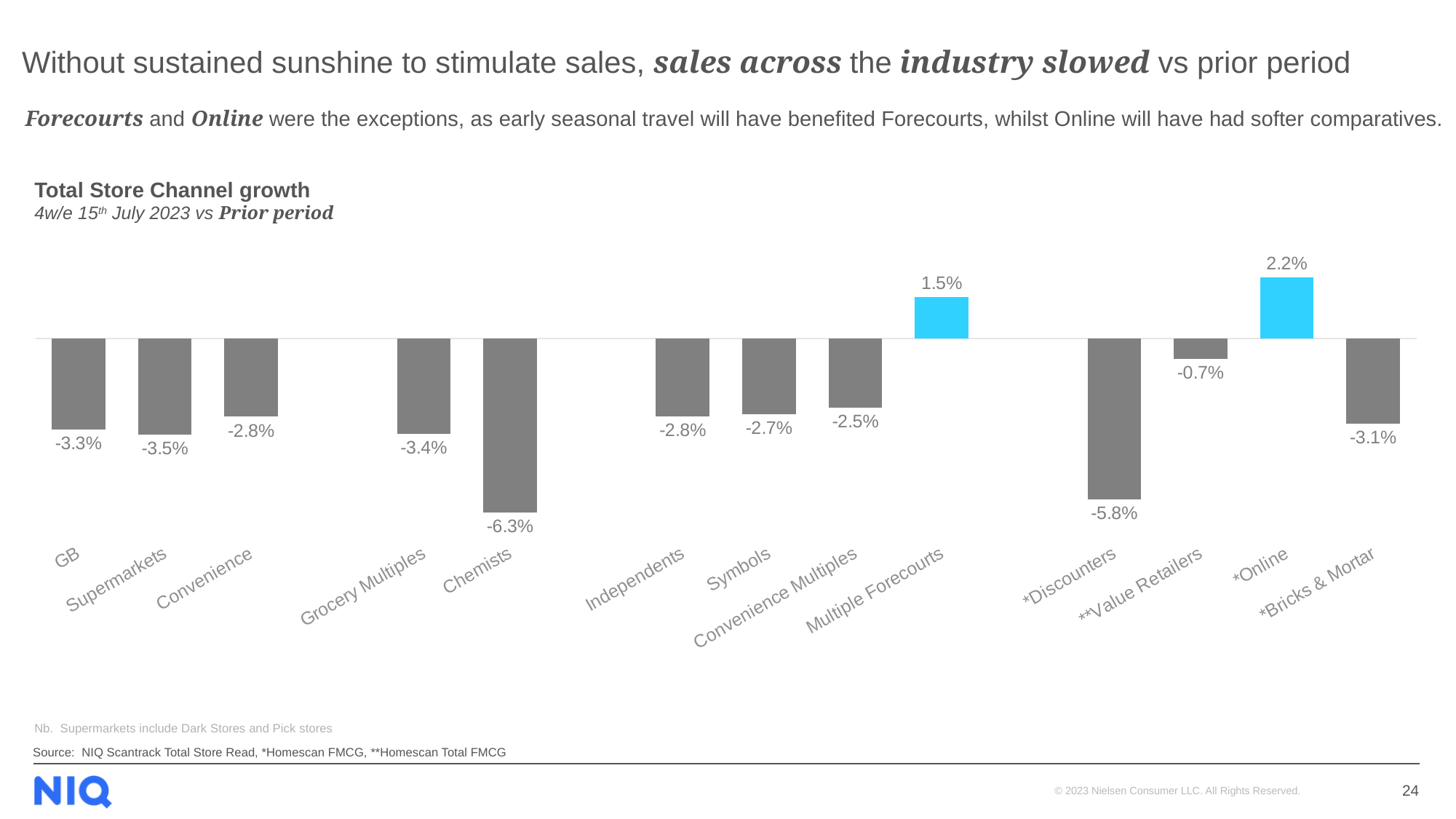
What is the growth value for *Online? 2.2% What type of chart is shown on the slide? Bar chart How many channels are shown in the chart? 13 Which has a higher growth value, Supermarkets or Convenience? Convenience What colour are the bars with positive growth values? Blue What is the growth value for Multiple Forecourts? 1.5% Which channel has the highest growth value? *Online What is the growth value for Chemists? -6.3% Which channel has the lowest growth value? Chemists What is the growth value for GB? -3.3% What is the growth value for *Discounters? -5.8% What is the difference between the growth values for *Online and Multiple Forecourts? 0.7 percentage points